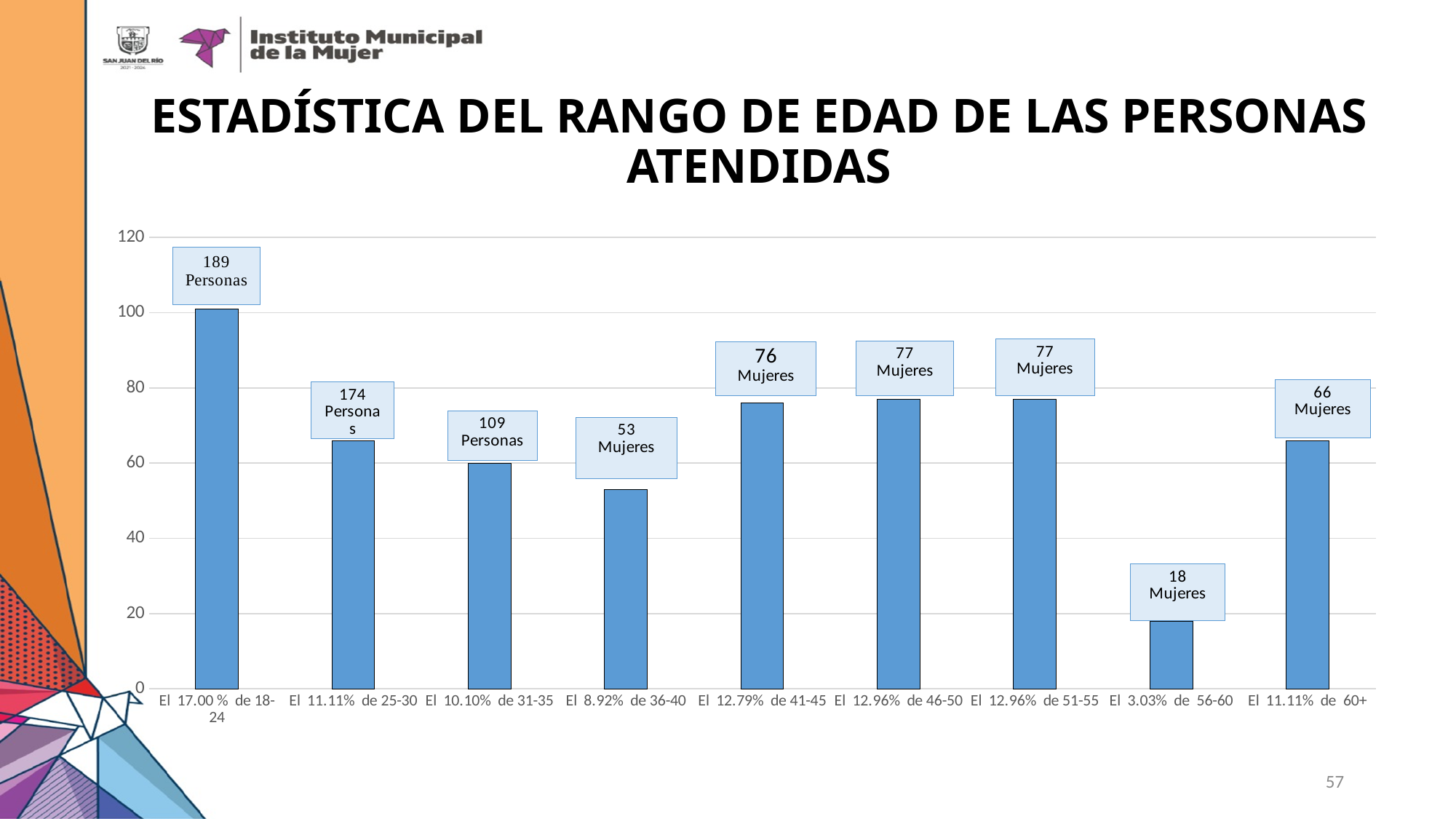
Is the value for the 18-24 bar greater or less than 80? greater Which bar is taller, 41-45 or 36-40? 41-45 How many age-range categories are plotted on the chart? 9 What value is labelled for the 60+ age range? 66 Mujeres Which age range has the tallest bar? 18-24 What value is labelled for the 41-45 age range? 76 Mujeres What value is labelled for the 56-60 age range? 18 Mujeres What value is labelled for the 36-40 age range? 53 Mujeres What kind of chart is shown on the slide? bar chart Which age range has the shortest bar? 56-60 What is the difference between the labelled values for 46-50 (77 Mujeres) and 36-40 (53 Mujeres)? 24 What percentage is shown in the category label for the 56-60 age range? 3.03%